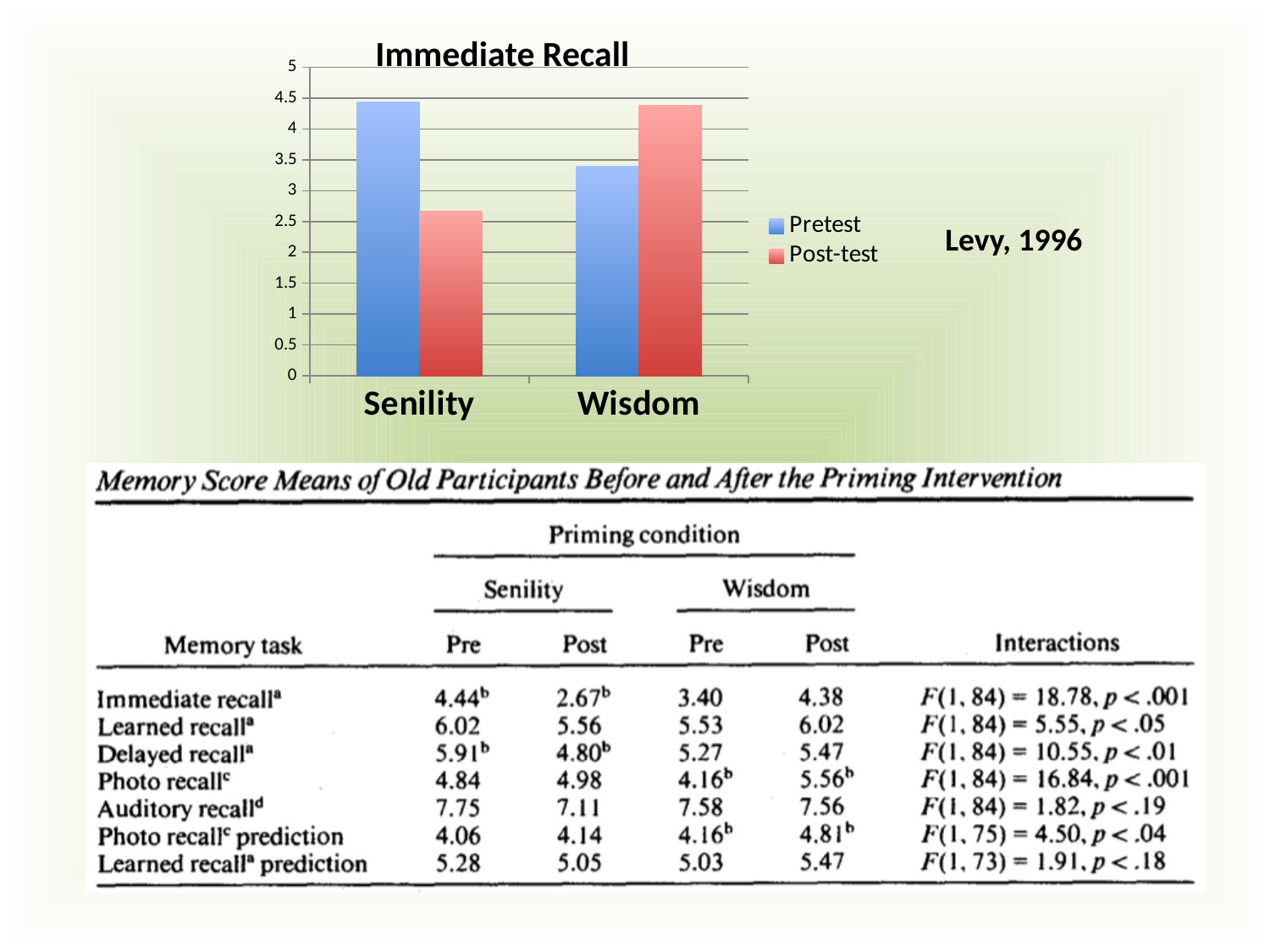
In the Immediate Recall chart, is the Pretest value for Senility greater or less than 4? greater What is the title of the bar chart? Immediate Recall In the Immediate Recall chart, is the Post-test value for Wisdom greater or less than 4? greater In the Immediate Recall chart, which is larger for Wisdom: the Pretest or the Post-test bar? Post-test What kind of chart is shown on the slide? bar chart In the Immediate Recall chart, which bar is the lowest of the four? Senility Post-test In the Immediate Recall chart, which is larger for Senility: the Pretest or the Post-test bar? Pretest In the Immediate Recall chart, is the Post-test value for Senility greater or less than 3? less How many categories are shown on the x axis of the Immediate Recall chart? 2 How many series does the legend of the Immediate Recall chart list? 2 Which colour represents the Post-test series in the chart? red